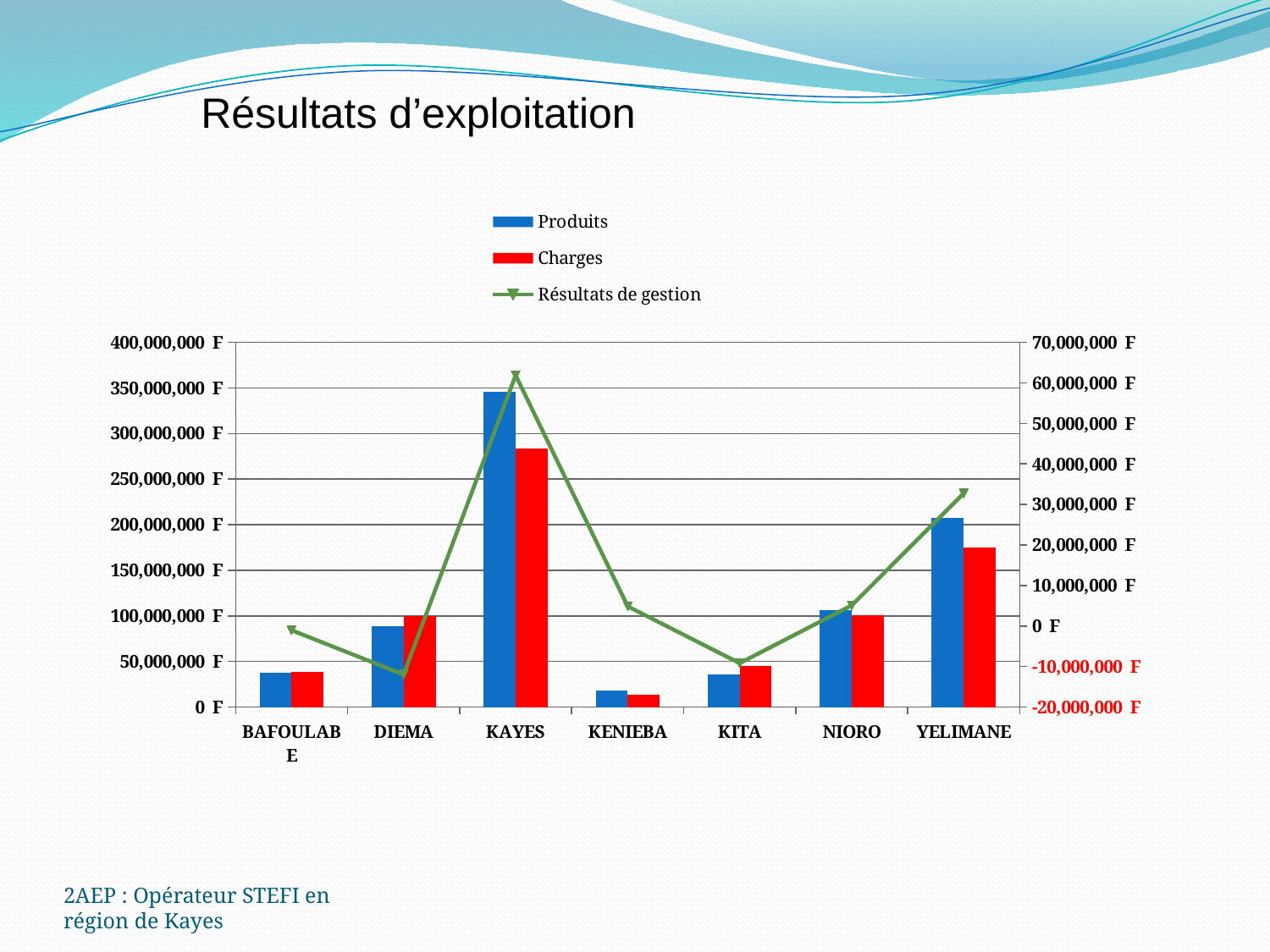
For KAYES, which is larger, Produits or Charges? Produits How many categories (localities) are shown on the x axis of the chart? 7 How many series does the chart legend list? 3 What colour are the Charges bars in the chart? red Is the Résultats de gestion value for KITA greater or less than 0 F? less For KITA, which is larger, Produits or Charges? Charges Which locality has the highest Charges value? KAYES Which locality has the highest Produits value? KAYES What kind of chart is used to plot the Produits and Charges series? bar chart Which locality has the lowest Résultats de gestion value? DIEMA Is the Produits value for KAYES greater or less than 300,000,000 F? greater Which locality has the lowest Produits value? KENIEBA